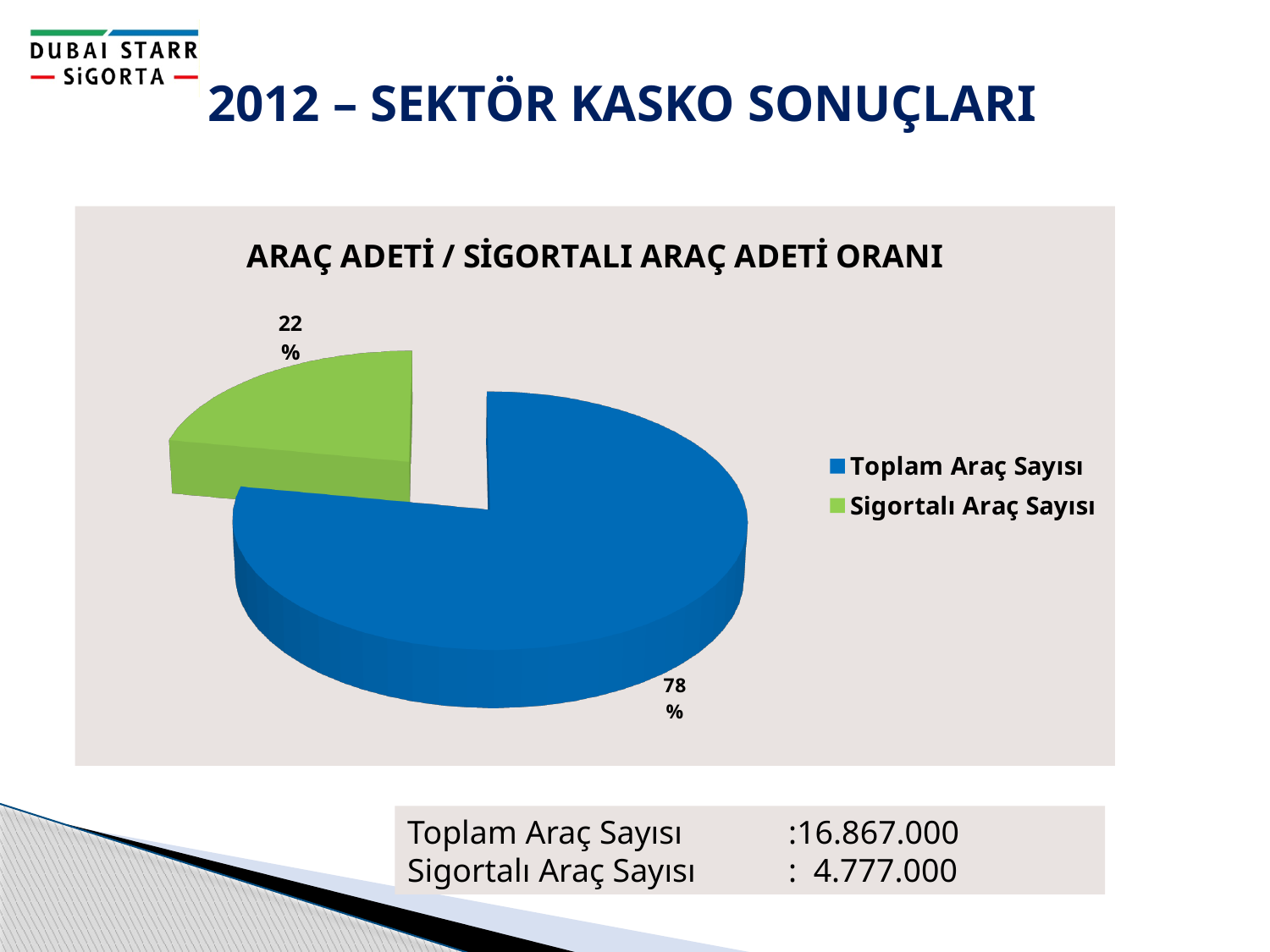
What share of the pie does Sigortalı Araç Sayısı represent? 22% Which is larger, the Toplam Araç Sayısı slice or the Sigortalı Araç Sayısı slice? Toplam Araç Sayısı By how many percentage points does the Toplam Araç Sayısı share exceed the Sigortalı Araç Sayısı share? 56 percentage points How many entries does the legend list? 2 What kind of chart is shown on the slide? pie chart What share of the pie does Toplam Araç Sayısı represent? 78% Which slice of the pie is the largest? Toplam Araç Sayısı Which slice of the pie is the smallest? Sigortalı Araç Sayısı What is the title of the pie chart? ARAÇ ADETİ / SİGORTALI ARAÇ ADETİ ORANI What colour is the Sigortalı Araç Sayısı slice? green How many slices does the pie chart have? 2